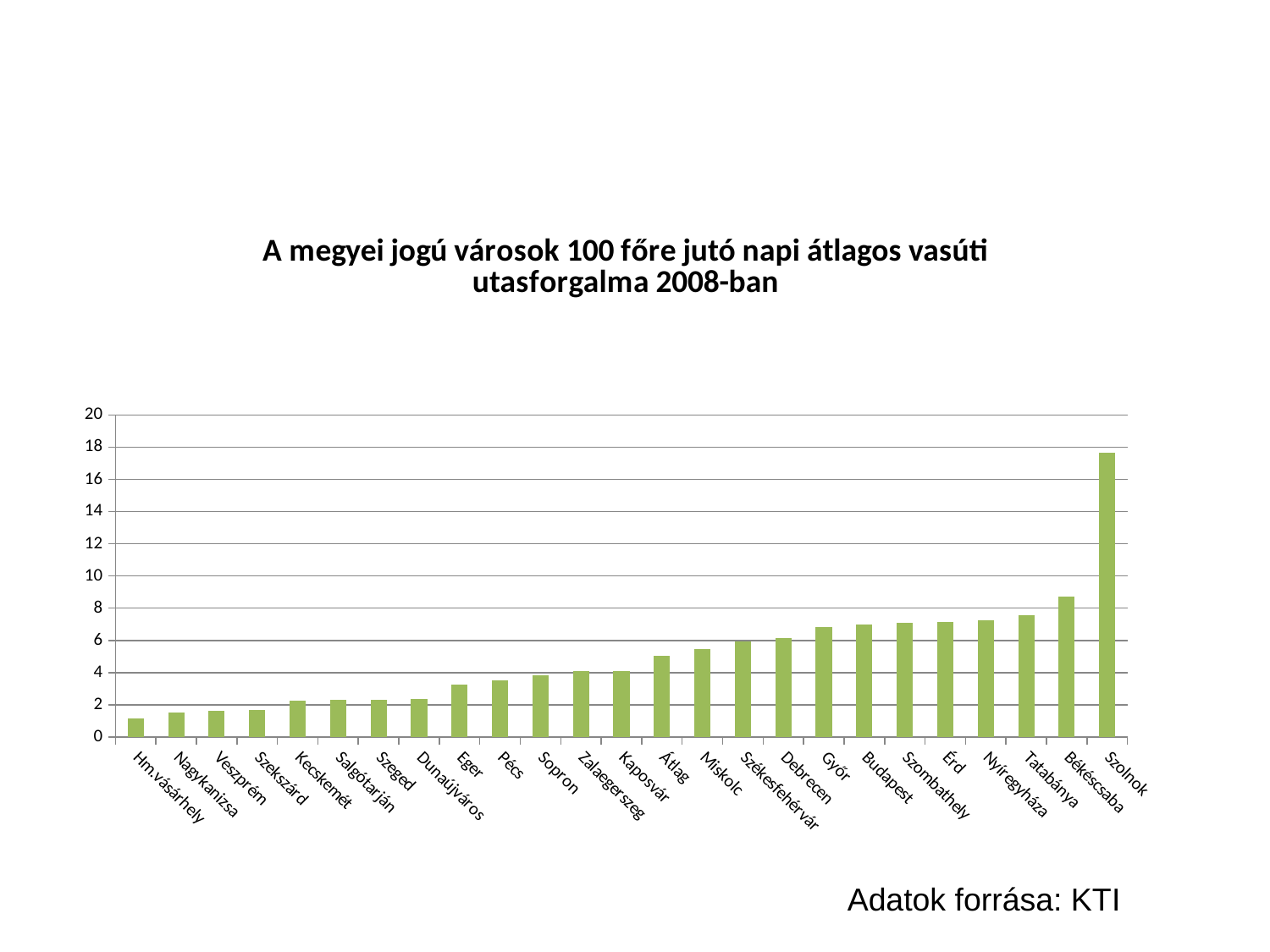
Is the value for Hm.vásárhely greater or less than 2? less Do the values generally rise or fall from left to right along the x axis? rise Is the value for Eger greater or less than 4? less Which is larger, the value for Miskolc or the value for Eger? Miskolc Which city has the highest value in the chart? Szolnok What kind of chart is shown on the slide? bar chart What is the title of the chart? A megyei jogú városok 100 főre jutó napi átlagos vasúti utasforgalma 2008-ban Which is larger, the value for Szolnok or the value for Békéscsaba? Szolnok Is the value for Szolnok greater or less than 16? greater Which city has the lowest value in the chart? Hm.vásárhely How many categories are plotted along the x axis? 25